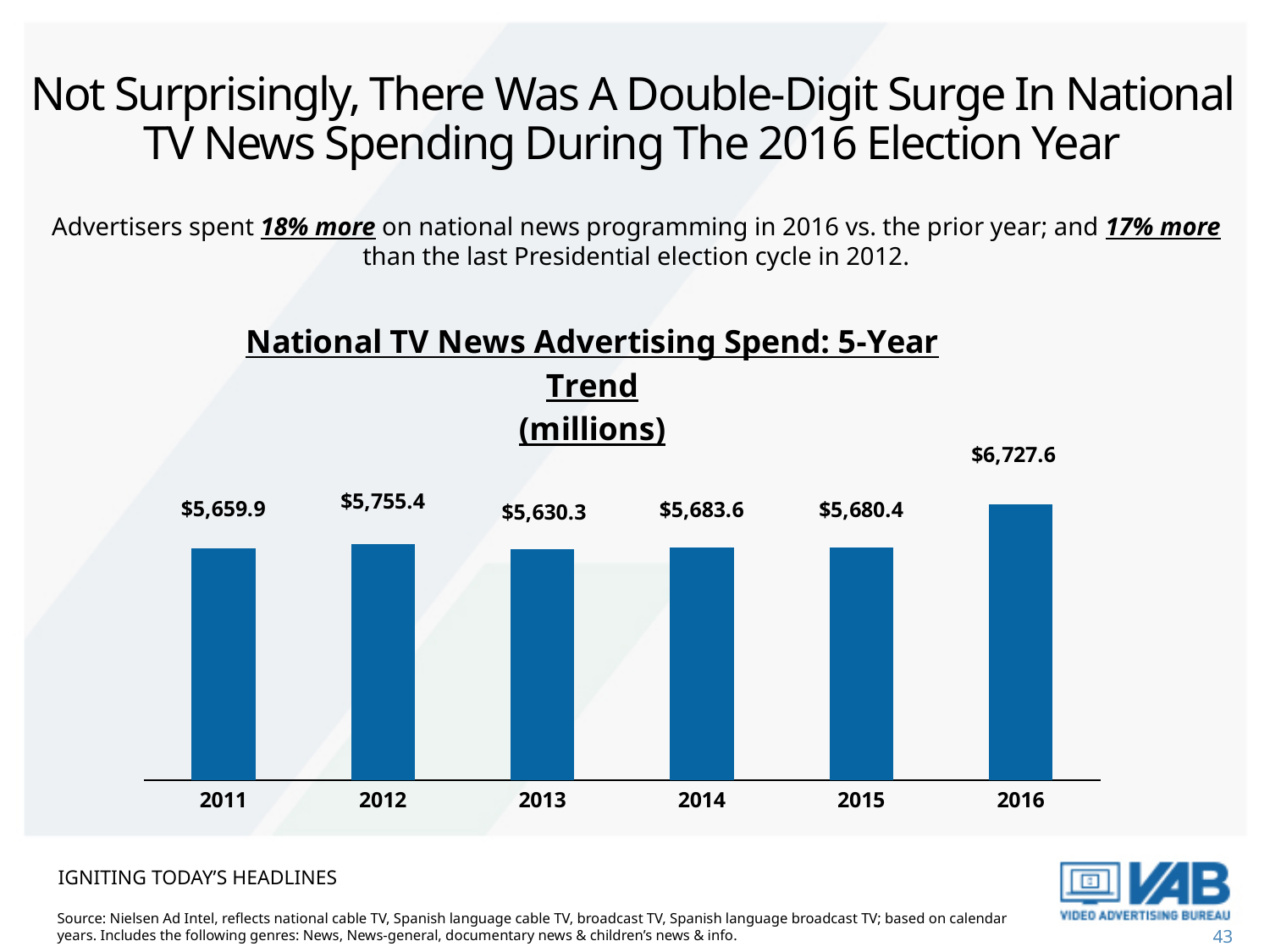
Which year has the highest national TV news advertising spend? 2016 What unit is stated in the chart title for the values? Millions What is the national TV news advertising spend for 2016? $6,727.6 What is the national TV news advertising spend for 2011? $5,659.9 What type of chart is shown on the slide? Bar chart What is the difference between the 2016 and 2015 advertising spend values? $1,047.2 Which year has a larger advertising spend, 2012 or 2014? 2012 Does the advertising spend rise or fall from 2015 to 2016? Rise What is the national TV news advertising spend for 2013? $5,630.3 How many years are shown on the chart? 6 Which year has the lowest national TV news advertising spend? 2013 What is the difference between the 2012 and 2011 advertising spend values? $95.5